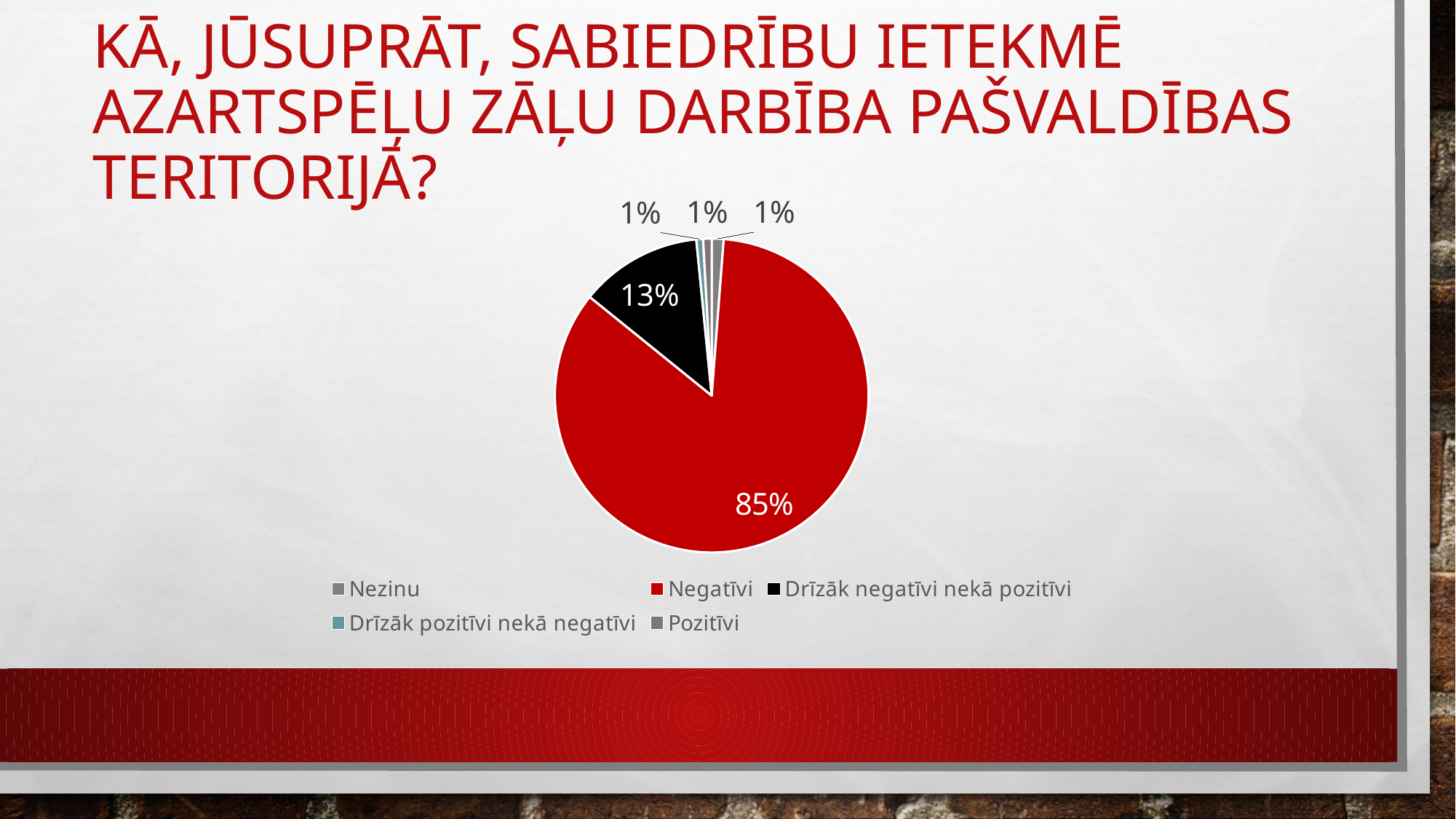
What is the value shown for "Nezinu"? 1% What colour is the "Negatīvi" slice? Red How many entries does the legend list? 5 Which is larger, "Negatīvi" or "Drīzāk negatīvi nekā pozitīvi"? Negatīvi What is the difference between the "Negatīvi" and "Drīzāk negatīvi nekā pozitīvi" values? 72% How many categories are shown in the pie chart? 5 What is the value shown for "Drīzāk pozitīvi nekā negatīvi"? 1% What is the value shown for "Drīzāk negatīvi nekā pozitīvi"? 13% What share of the pie does the "Negatīvi" slice represent? 85% What kind of chart is shown on the slide? Pie chart Which category has the largest slice of the pie? Negatīvi What is the value shown for "Pozitīvi"? 1%